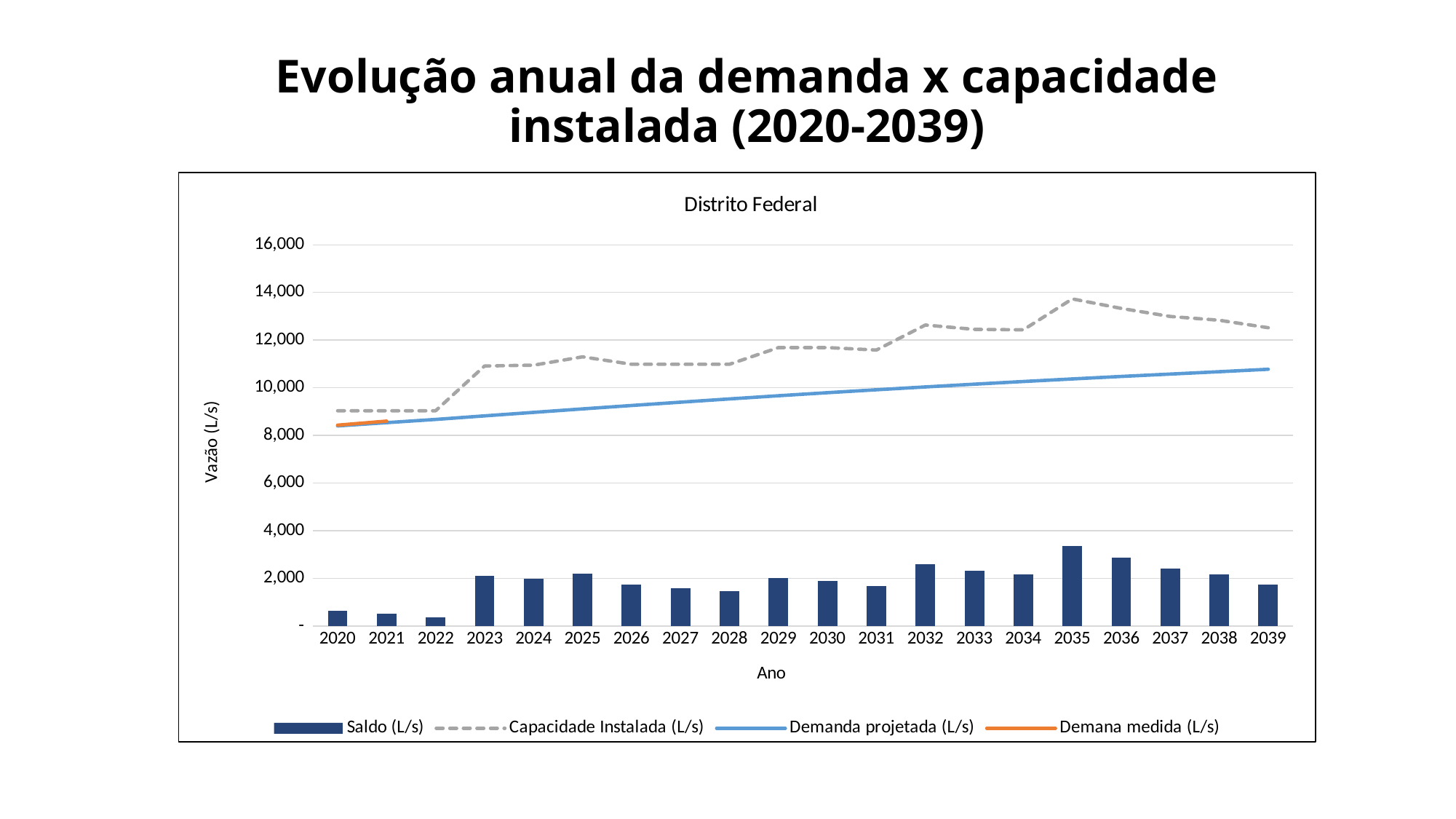
Does the Demanda projetada (L/s) line rise or fall from 2020 to 2039? rise Is the Saldo (L/s) value for 2035 greater or less than 2,000? greater What kind of chart is shown on the slide? A combined bar and line chart Is the Capacidade Instalada (L/s) value for 2035 greater or less than 12,000? greater In which year is the Saldo (L/s) bar the tallest? 2035 What is the label of the vertical axis of the chart? Vazão (L/s) In which year is the Saldo (L/s) bar the shortest? 2022 How many series does the chart legend list? 4 In 2035, which is higher: Capacidade Instalada (L/s) or Demanda projetada (L/s)? Capacidade Instalada (L/s) Is the Saldo (L/s) value for 2020 greater or less than 2,000? less How many years are shown on the x axis of the chart? 20